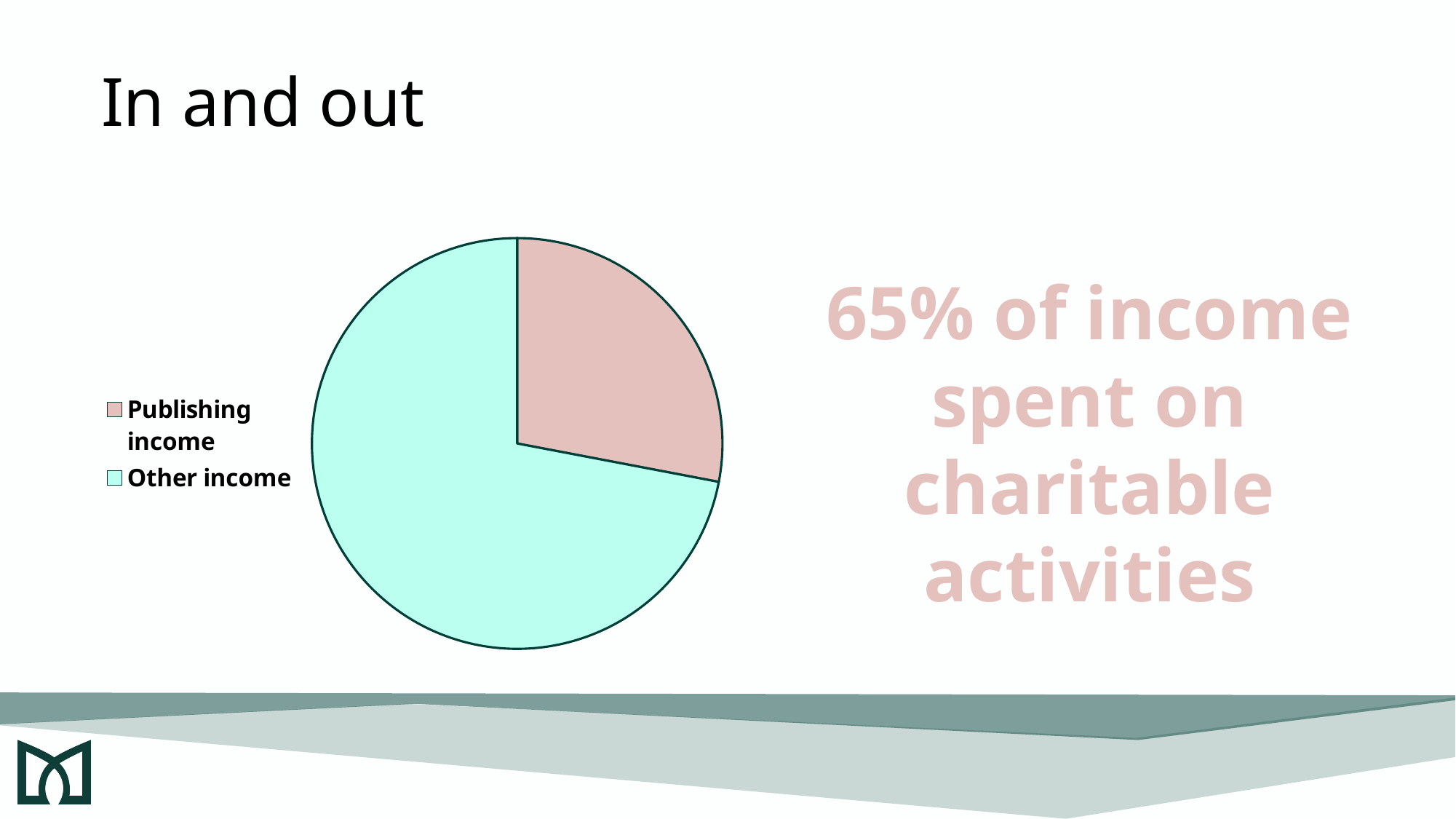
Which category has the largest slice in the pie chart? Other income How many entries does the legend of the pie chart list? 2 What colour is the Publishing income slice in the pie chart? Pink Which slice is larger in the pie chart, Publishing income or Other income? Other income How many slices does the pie chart have? 2 What kind of chart is shown on the slide? Pie chart Is the Publishing income slice more or less than half of the pie? Less Is the Other income slice more or less than half of the pie? More What colour is the Other income slice in the pie chart? Light teal Which category has the smallest slice in the pie chart? Publishing income